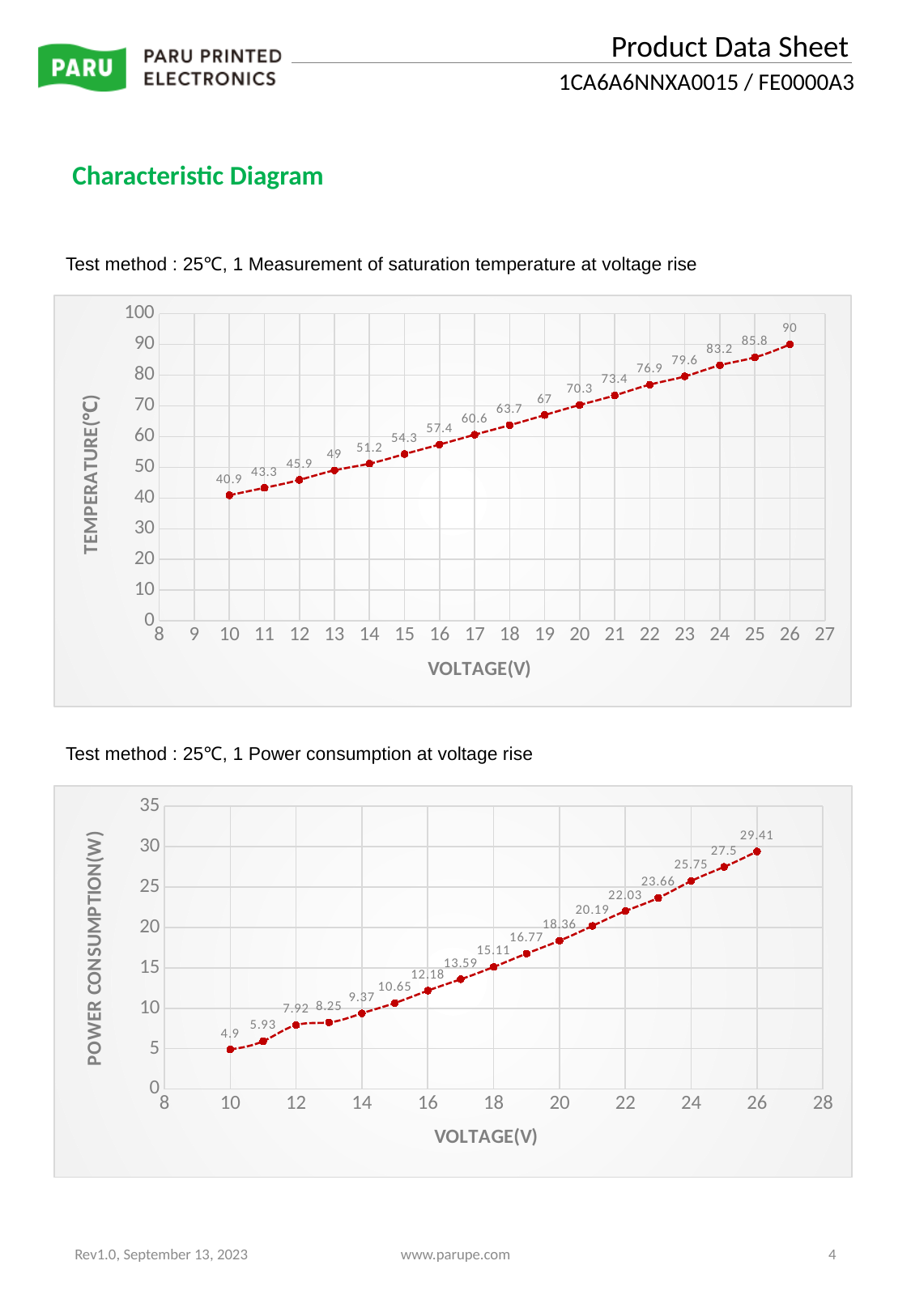
In the bottom chart (power consumption vs voltage), what is the power consumption at 26 V? 29.41 In the top chart (temperature vs voltage), what is the temperature at 20 V? 70.3 In the top chart (temperature vs voltage), what is the difference between the temperature at 26 V and at 10 V? 49.1 In the bottom chart (power consumption vs voltage), which is larger: the power consumption at 22 V or at 18 V? 22 V In the bottom chart (power consumption vs voltage), what is the power consumption at 16 V? 12.18 In the bottom chart (power consumption vs voltage), what is the difference between the power consumption at 13 V and at 12 V? 0.33 In the top chart (temperature vs voltage), what is the temperature at 10 V? 40.9 In the top chart (temperature vs voltage), at which voltage is the temperature highest? 26 In the top chart (temperature vs voltage), does the temperature rise or fall as voltage increases? rise What is the y-axis label of the bottom chart? POWER CONSUMPTION(W) In the top chart (temperature vs voltage), how many data points are plotted? 17 In the bottom chart (power consumption vs voltage), at which voltage is the power consumption lowest? 10